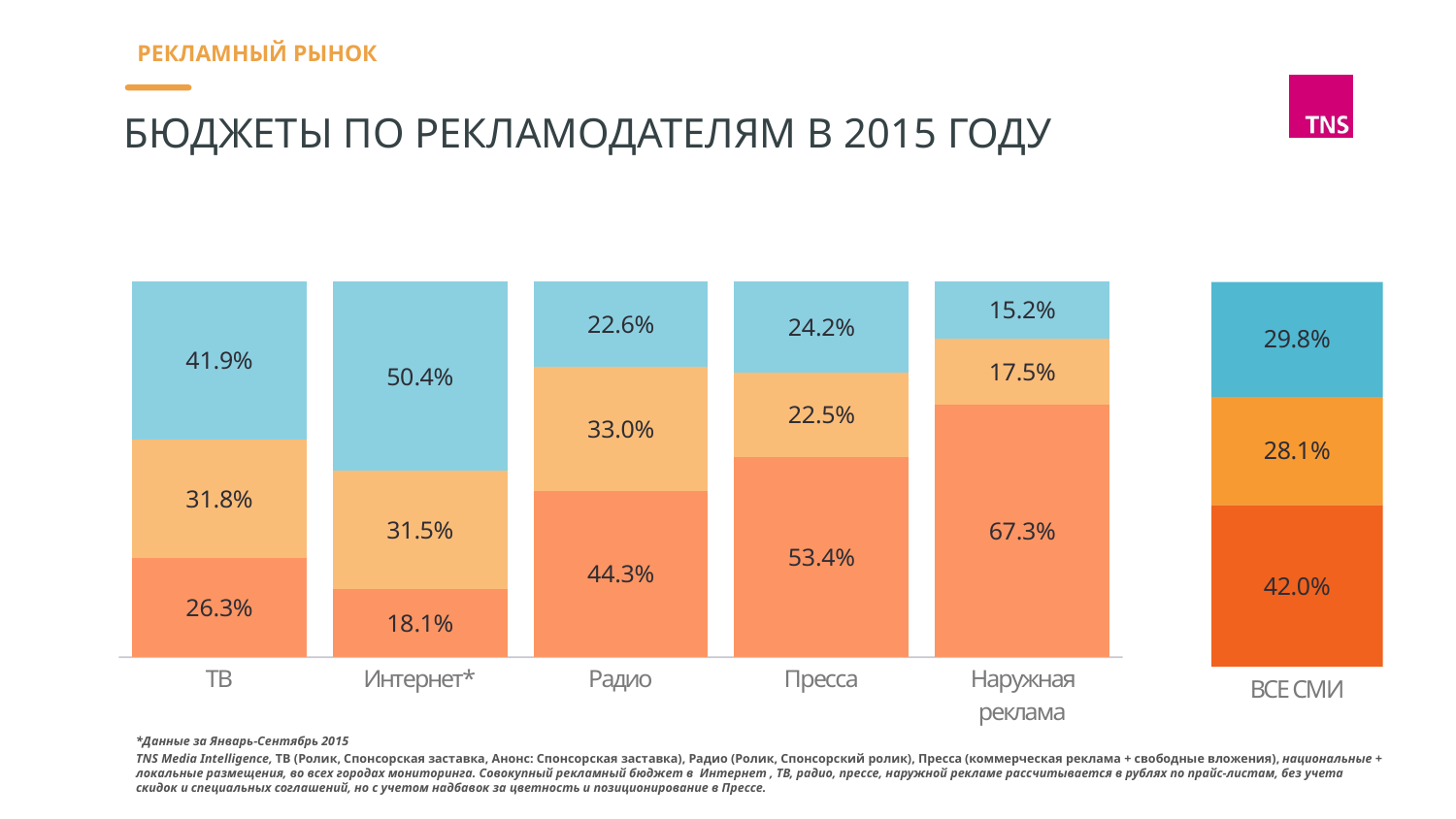
In the left chart, which category has the largest top (light blue) segment? Интернет* In the left chart, what is the value of the middle (light orange) segment for Радио? 33.0% In the left chart, what is the value of the bottom segment for Наружная реклама? 67.3% In the right chart (ВСЕ СМИ), what is the value of the bottom segment? 42.0% In the left chart, which category has the smallest bottom (dark orange) segment? Интернет* In the left chart, what is the value of the top (light blue) segment for Интернет*? 50.4% What type of chart is shown on the slide? Stacked bar chart In the left chart, what is the value of the bottom (dark orange) segment for ТВ? 26.3% What is the title of the slide's chart? БЮДЖЕТЫ ПО РЕКЛАМОДАТЕЛЯМ В 2015 ГОДУ In the left chart, which is larger: the top segment for Пресса or the top segment for Наружная реклама? Пресса In the left chart, what is the difference between the bottom segment values for Пресса and Радио? 9.1% In the left chart, how many categories are shown on the x axis? 5